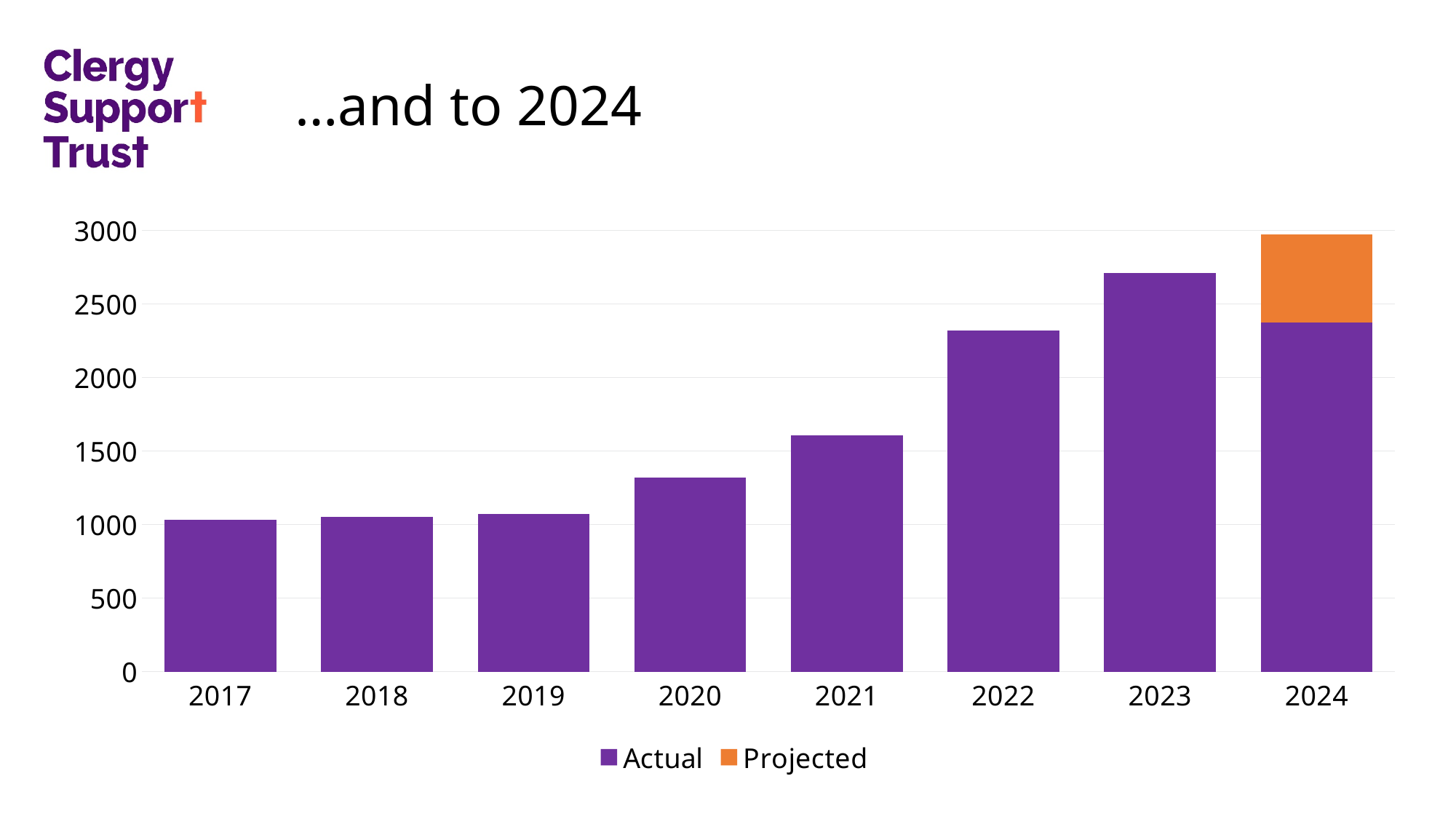
Is the value for 2020 greater or less than 1000? greater Which is larger, the Actual value for 2023 or the Actual value for 2024? 2023 Which series in the chart is shown in orange? Projected Is the value for 2017 greater or less than 1500? less Is the value for 2023 greater or less than 2500? greater How many years are shown on the x axis of the chart? 8 How many series does the chart's legend list? 2 Which is larger, the bar for 2022 or the bar for 2023? 2023 What kind of chart is shown on the slide? bar chart Which year has the tallest bar in the chart? 2024 Do the bar values generally rise or fall from 2017 to 2024? rise